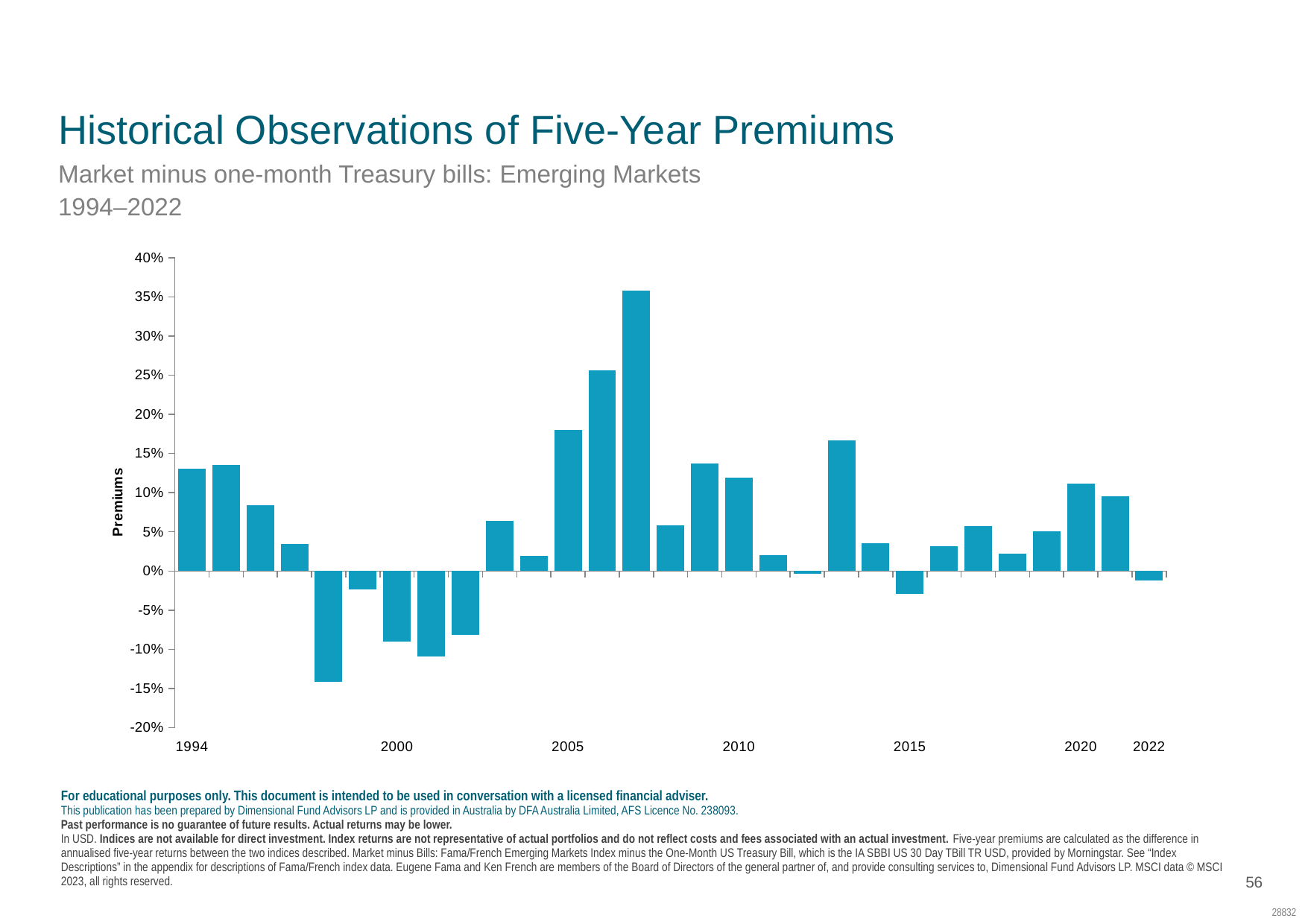
Which year has the highest five-year premium in the chart? 2007 Which year has the lowest five-year premium in the chart? 1998 Is the value for 2007 greater or less than 30%? greater What range of years does the chart's subtitle say it covers? 1994–2022 Is the value for 2015 greater or less than 0%? less Is the value for 2005 greater or less than 15%? greater Which year has the larger premium, 2005 or 2010? 2005 What kind of chart is shown on the slide? bar chart Which year has the larger premium, 2000 or 2020? 2020 How many bars (years) are plotted in the chart? 29 What is the label on the vertical axis of the chart? Premiums